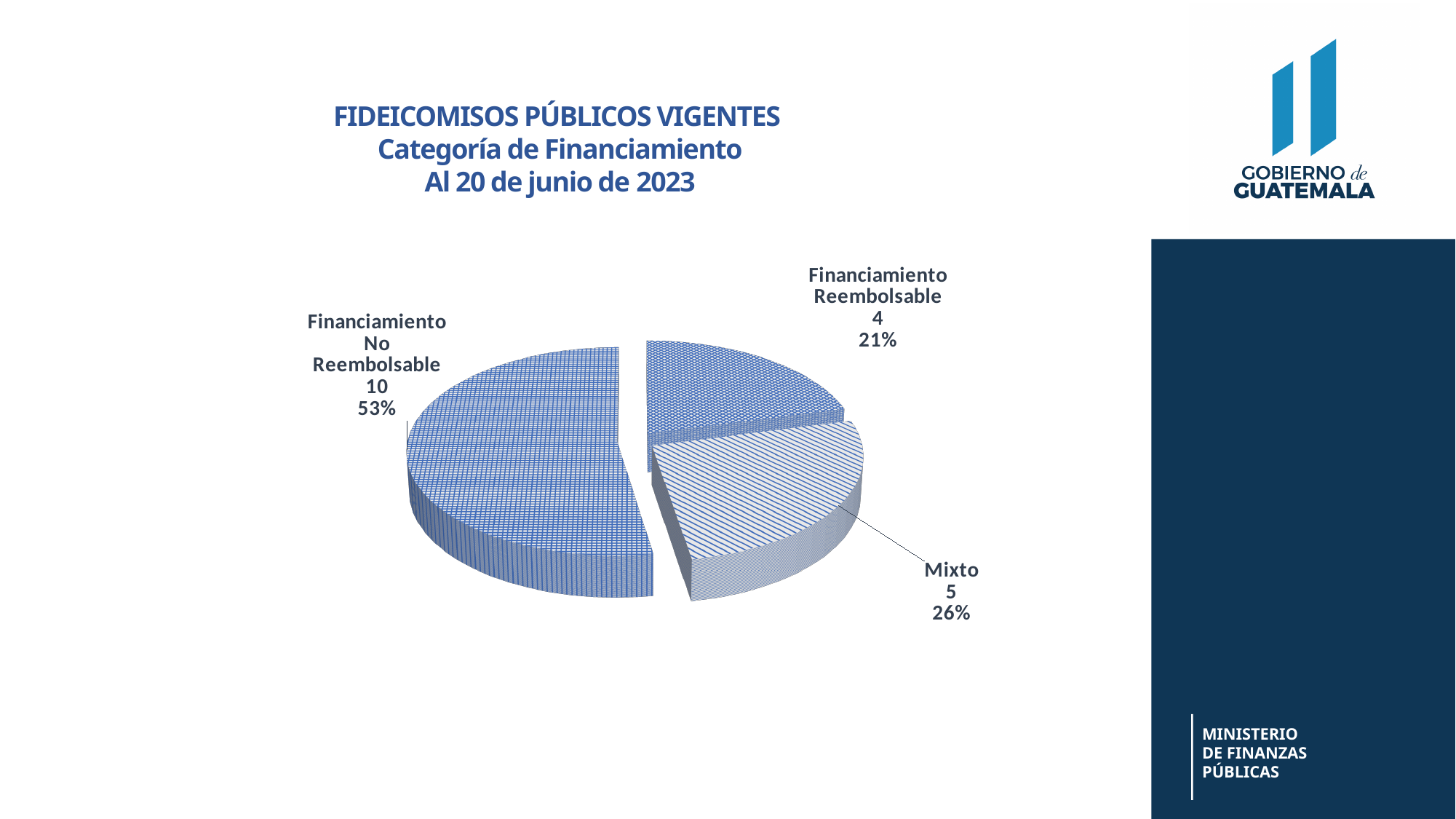
How many fideicomisos are in the Mixto category? 5 How many categories does the pie chart show? 3 What is the difference in count between Financiamiento No Reembolsable and Mixto? 5 What is the total number of fideicomisos across all three categories? 19 What share of the pie does Mixto represent? 26% How many fideicomisos are in the Financiamiento No Reembolsable category? 10 Which category has the smallest slice of the pie? Financiamiento Reembolsable What share of the pie does Financiamiento No Reembolsable represent? 53% Which category has the largest slice of the pie? Financiamiento No Reembolsable How many fideicomisos are in the Financiamiento Reembolsable category? 4 What kind of chart is shown on the slide? Pie chart What share of the pie does Financiamiento Reembolsable represent? 21%